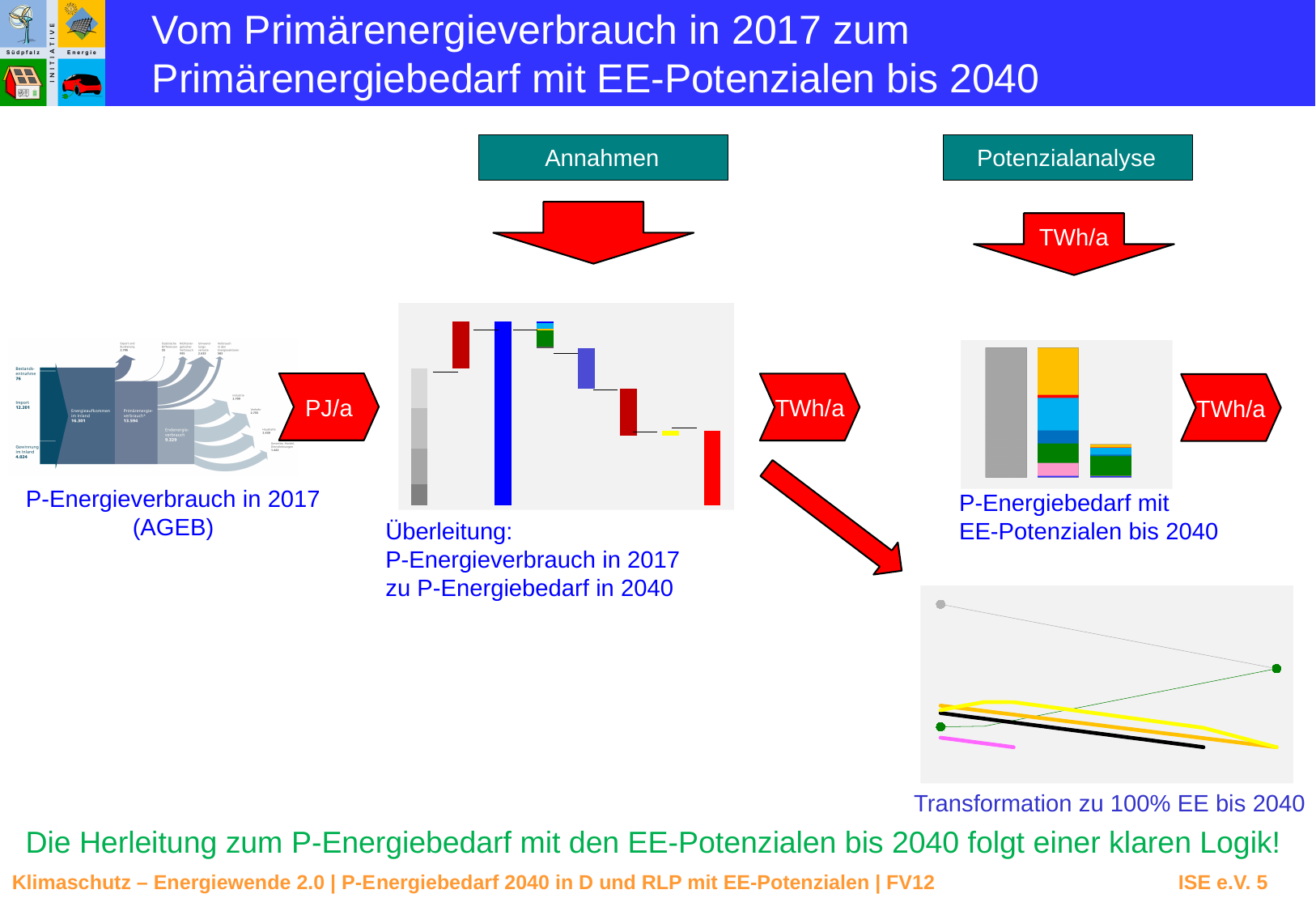
In the middle 'Überleitung' chart, which colour bar is the tallest? the blue bar In the middle 'Überleitung' chart, which is taller, the blue bar or the red bar at the far right? the blue bar How many bars are shown in the chart captioned 'P-Energiebedarf mit EE-Potenzialen bis 2040'? 3 What kind of chart is the middle chart captioned 'Überleitung: P-Energieverbrauch in 2017 zu P-Energiebedarf in 2040'? bar chart What colour is the top segment of the tall stacked bar in the chart captioned 'P-Energiebedarf mit EE-Potenzialen bis 2040'? orange In the bottom-right line chart, does the grey line rise or fall from left to right? fall What is the caption below the bottom-right line chart? Transformation zu 100% EE bis 2040 In the chart captioned 'P-Energiebedarf mit EE-Potenzialen bis 2040', which bar is the shortest? the rightmost bar What kind of chart is the bottom-right chart captioned 'Transformation zu 100% EE bis 2040'? line chart How many bars are shown in the middle 'Überleitung' chart? 8 What kind of chart is the chart captioned 'P-Energiebedarf mit EE-Potenzialen bis 2040'? stacked bar chart